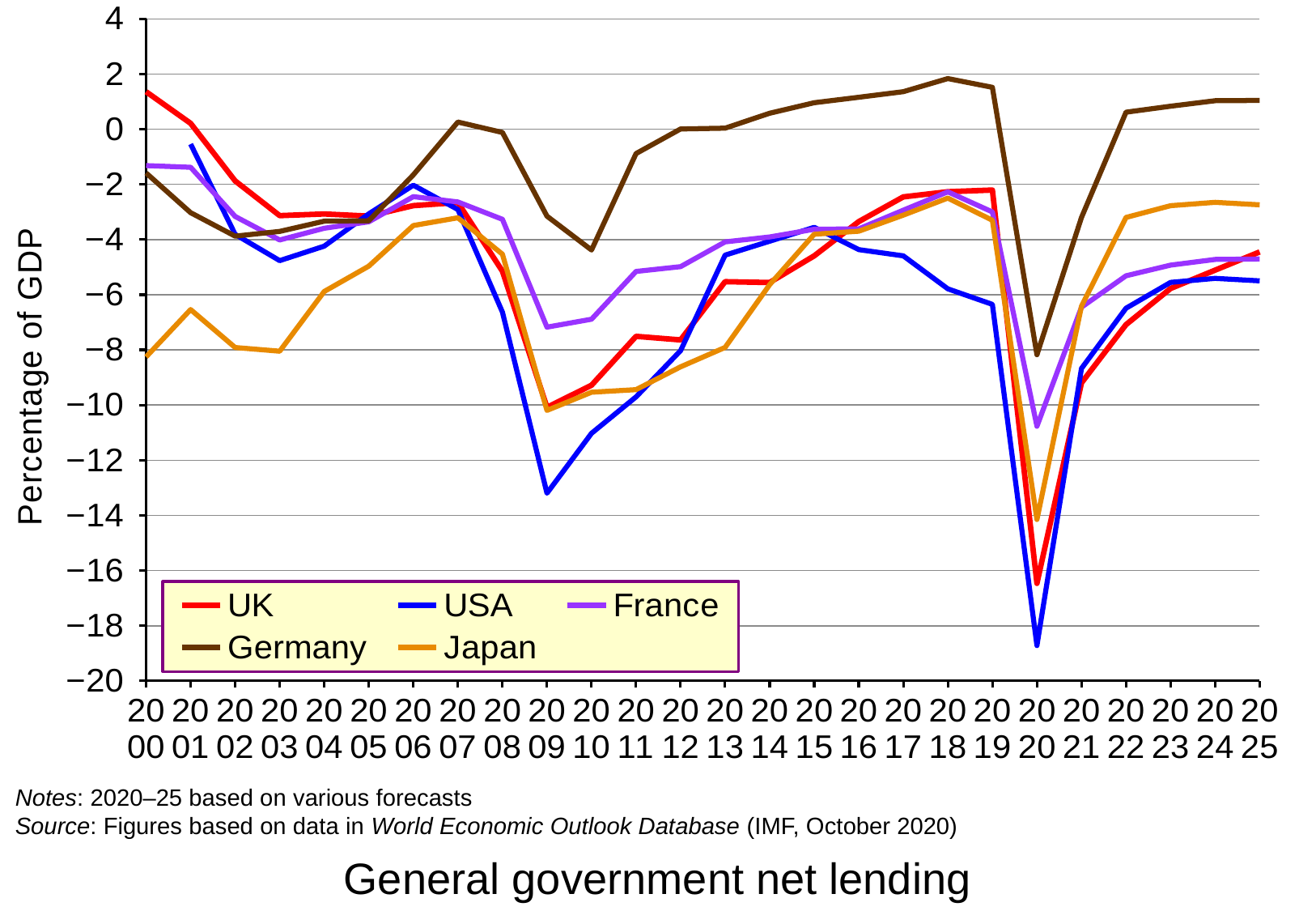
Does the value for Germany rise or fall from 2020 to 2022? rise Is the value for Japan in 2003 greater or less than -6? less How many years are shown along the x axis? 26 Which country has the lowest value in 2020? USA Is the value for Germany in 2018 greater or less than 0? greater In 2009, which is higher, the UK or the USA? UK Which country has the lowest value in 2000? Japan What kind of chart is shown on the slide? line chart Which country has the highest value in 2020? Germany Is the value for the USA in 2009 greater or less than -12? less What is the title of the chart? General government net lending How many series does the legend list? 5